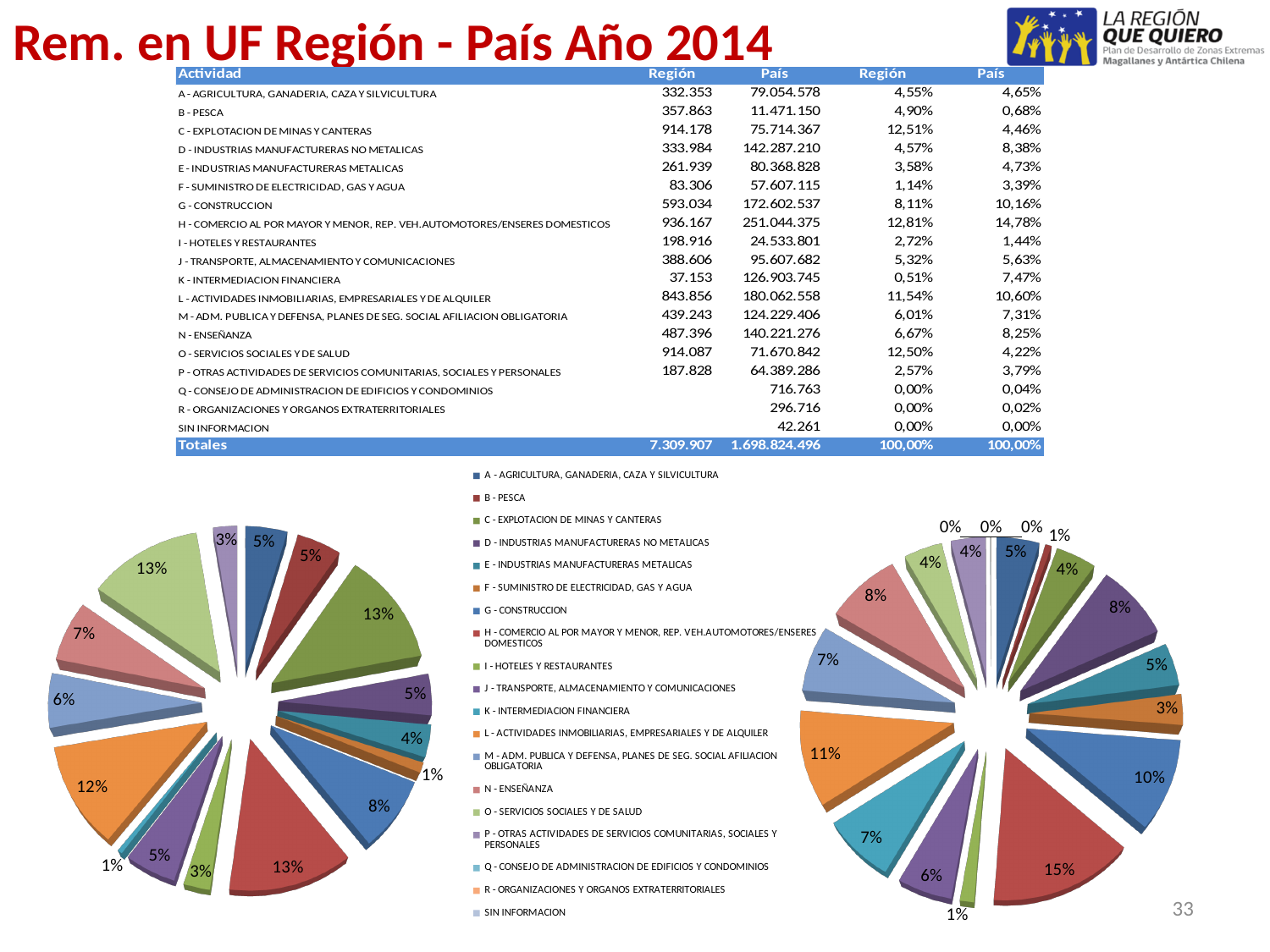
In the left pie chart (Región), what share is shown for the orange slice representing L - ACTIVIDADES INMOBILIARIAS, EMPRESARIALES Y DE ALQUILER? 12% In the right pie chart (País), what share is shown for the slice representing G - CONSTRUCCION? 10% What is the title of the slide containing the two pie charts? Rem. en UF Región - País Año 2014 In the left pie chart (Región), how many slices are labelled 13%? 3 In the right pie chart (País), which category does the largest slice (15%) represent? H - COMERCIO AL POR MAYOR Y MENOR, REP. VEH.AUTOMOTORES/ENSERES DOMESTICOS How many entries does the shared legend between the two pie charts list? 19 In the right pie chart (País), what is the share of the largest slice? 15% In the right pie chart (País), what is the share shown for the smallest slices? 0% Which is larger: the 15% slice in the right pie chart or the 12% slice in the left pie chart? the 15% slice in the right pie chart How many slices in the right pie chart (País) are labelled 0%? 3 What kind of chart is shown at the bottom left of the slide? pie chart In the right pie chart (País), what share is shown for the slice representing L - ACTIVIDADES INMOBILIARIAS, EMPRESARIALES Y DE ALQUILER? 11%